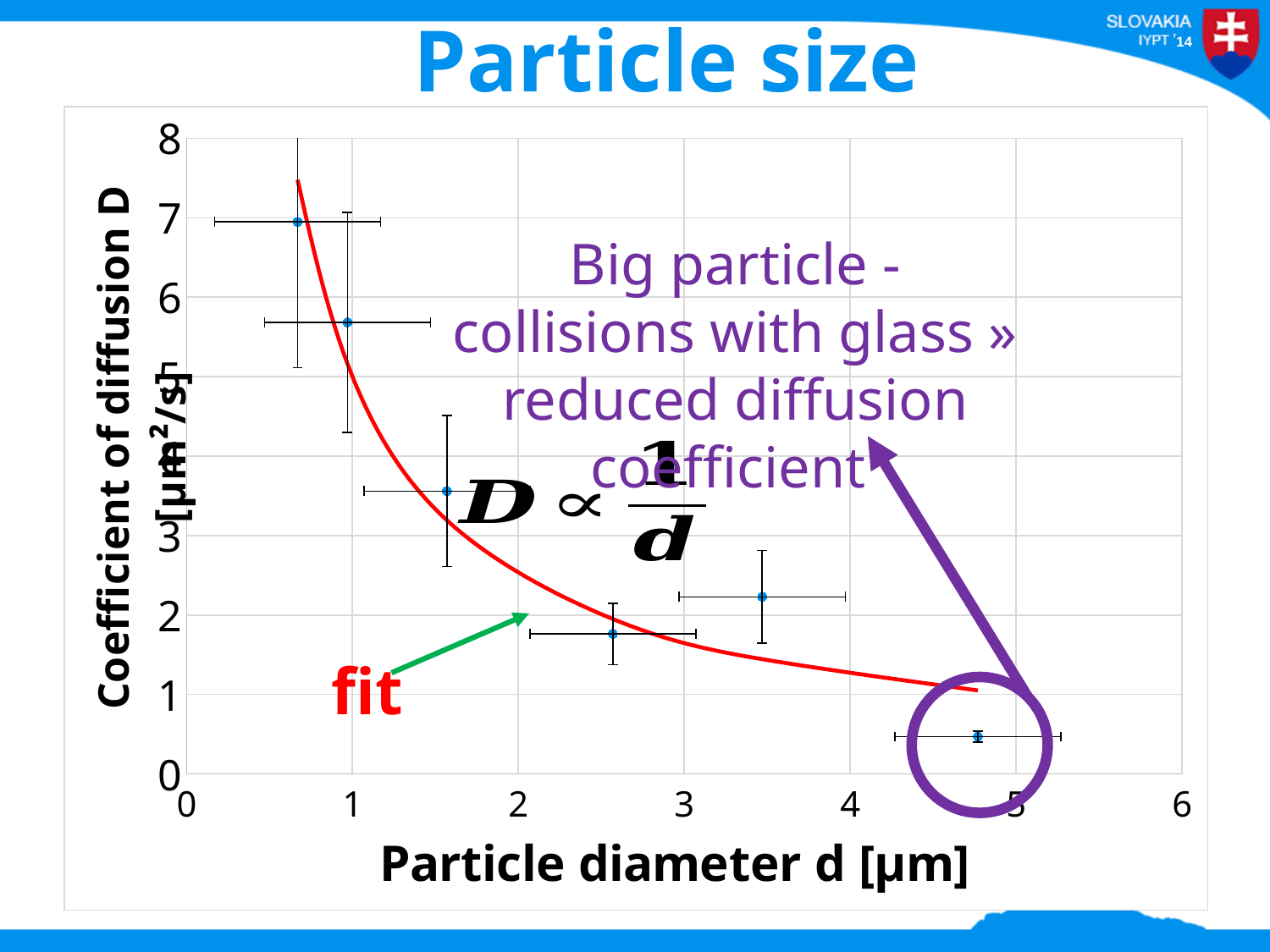
Is the coefficient of diffusion for the data point with the smallest particle diameter (near 0.7 μm) greater or less than 6? greater What is the title of the slide containing the chart? Particle size What kind of chart is shown on the slide? Scatter chart with error bars and a fit curve Is the coefficient of diffusion for the data point near a diameter of 3.5 μm greater or less than 3? less Does the coefficient of diffusion generally rise or fall as the particle diameter increases? fall Is the coefficient of diffusion for the data point near a diameter of 2.6 μm greater or less than 3? less What is the label of the x axis? Particle diameter d [μm] How many data points are plotted in the chart? 6 Does the data point with the highest coefficient of diffusion have the smallest or the largest particle diameter? smallest Which has the larger coefficient of diffusion: the data point near 0.7 μm or the data point near 4.8 μm? the point near 0.7 μm